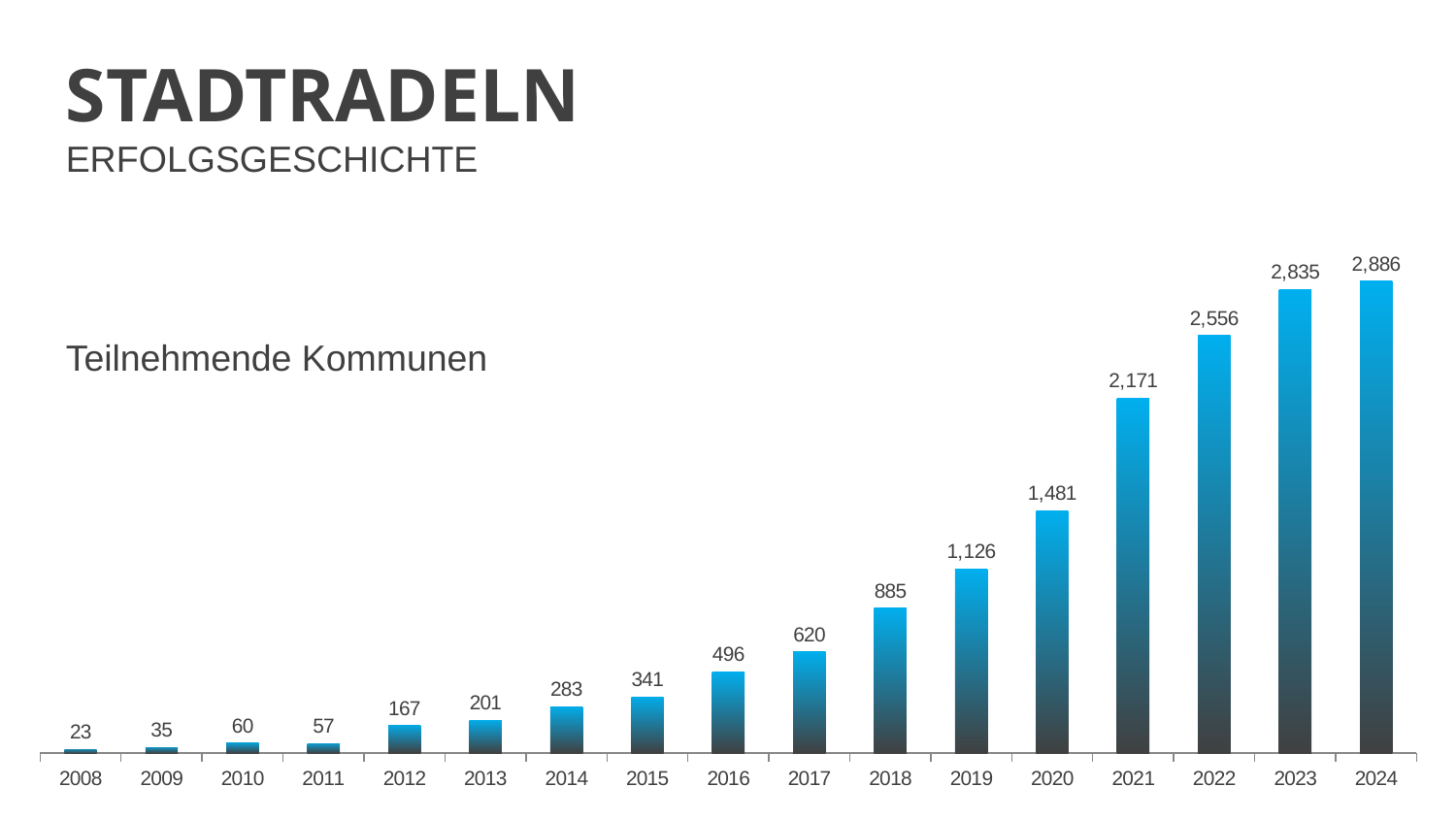
What is the value for 2008? 23 What is the difference between the values for 2020 and 2019? 355 What is the difference between the values for 2024 and 2023? 51 How many years are shown on the x axis? 17 What kind of chart is this? bar chart What is the value for 2016? 496 Do the values generally rise or fall from 2008 to 2024? rise What is the label of the chart? Teilnehmende Kommunen Which year has the lowest value? 2008 Which year has the highest value? 2024 Which is larger, the value for 2010 or the value for 2011? 2010 What is the value for 2021? 2,171